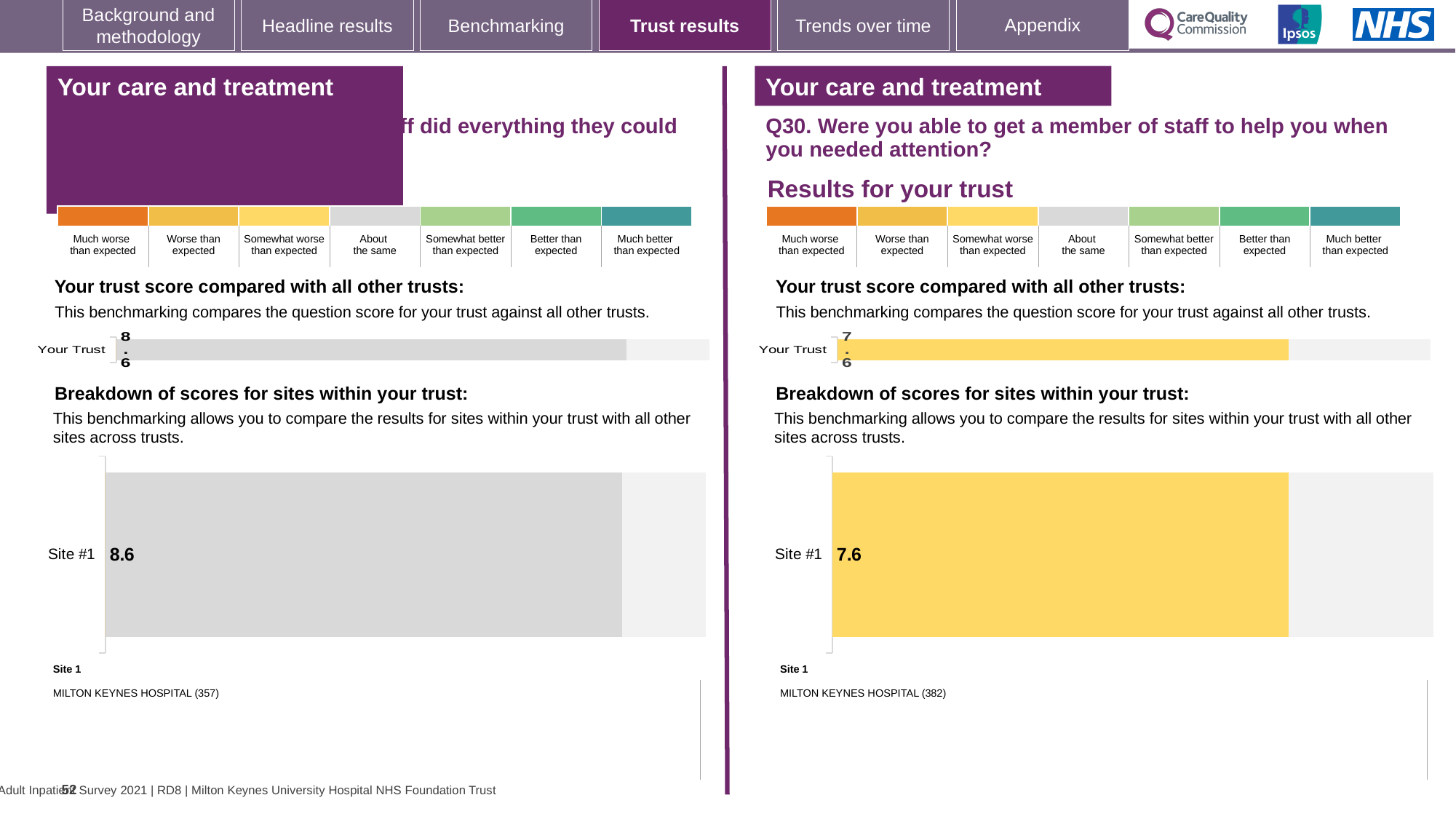
On the right-hand chart for Q30, is the Your Trust score greater or less than the Your Trust score on the left-hand chart? less Which is larger: the Site #1 score on the left-hand chart or the Site #1 score on the right-hand chart for Q30? Left-hand chart (8.6) On the left-hand chart, which site is listed as Site 1? MILTON KEYNES HOSPITAL (357) On the right-hand chart for Q30, what is the score for Site #1? 7.6 What kind of chart is used to show the Site #1 score on the right-hand chart for Q30? Bar chart On the left-hand chart, what is the score for Site #1? 8.6 How many sites are shown in the breakdown of scores on the right-hand chart for Q30? 1 On the right-hand chart for Q30, what is the score shown for Your Trust? 7.6 What is the difference between the Site #1 score on the left-hand chart and the Site #1 score on the right-hand chart for Q30? 1.0 On the right-hand chart for Q30, which site is listed as Site 1? MILTON KEYNES HOSPITAL (382) On the left-hand chart, what is the score shown for Your Trust? 8.6